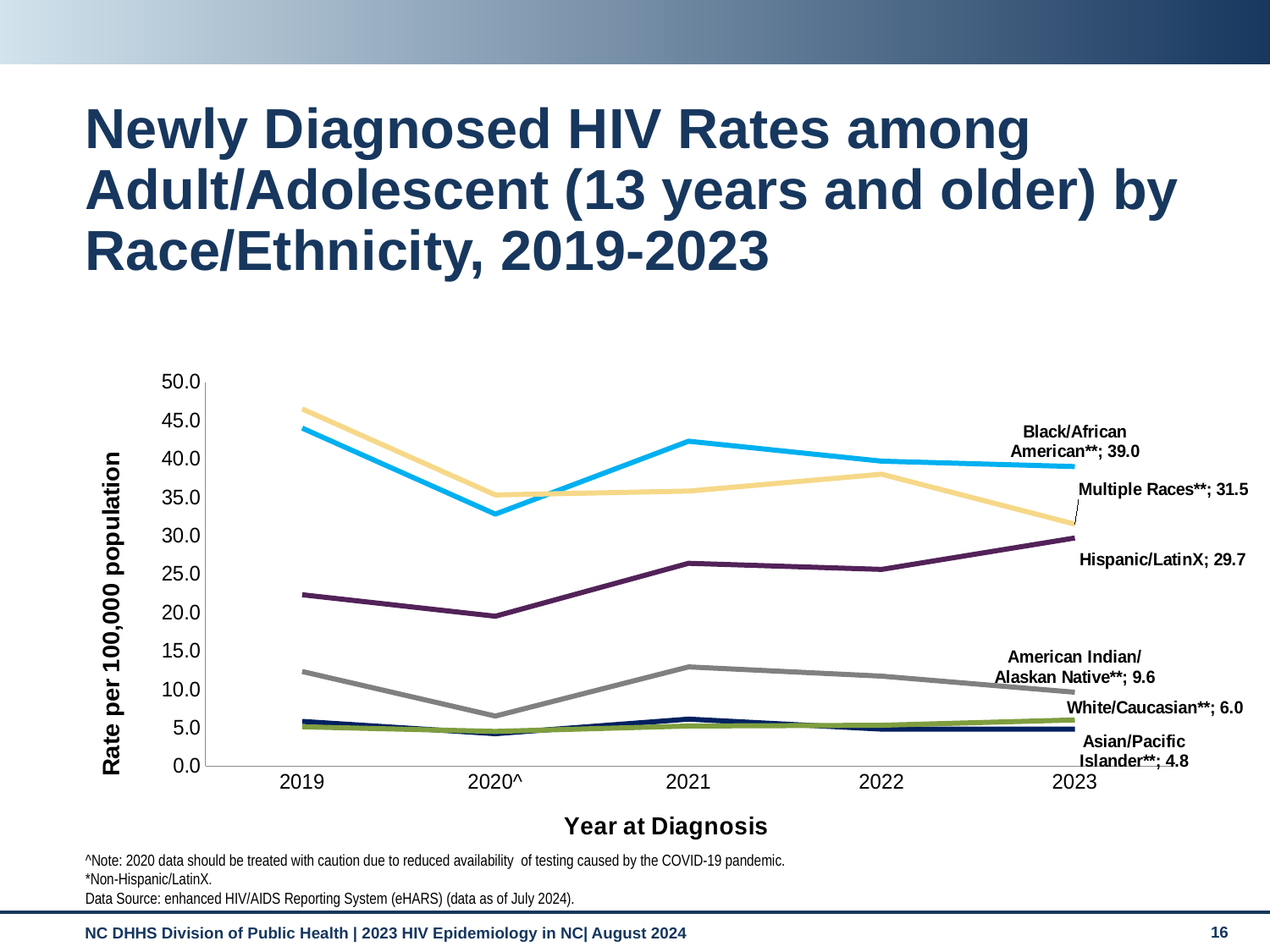
What is the 2023 rate for Asian/Pacific Islander? 4.8 In 2023, which is larger: the rate for American Indian/Alaskan Native or the rate for White/Caucasian? American Indian/Alaskan Native Which race/ethnicity has the highest rate in 2023? Black/African American Which race/ethnicity has the lowest rate in 2023? Asian/Pacific Islander What is the 2023 rate for Hispanic/LatinX? 29.7 What type of chart is shown on the slide? line chart Is the 2019 rate for Multiple Races greater or less than 40.0? greater What is the difference between the 2023 rates for Black/African American and Multiple Races? 7.5 What is the 2023 rate for Black/African American? 39.0 How many years are shown on the x axis? 5 Does the Hispanic/LatinX rate rise or fall from 2020 to 2023? rise Is the 2020 rate for Black/African American greater or less than 35.0? less